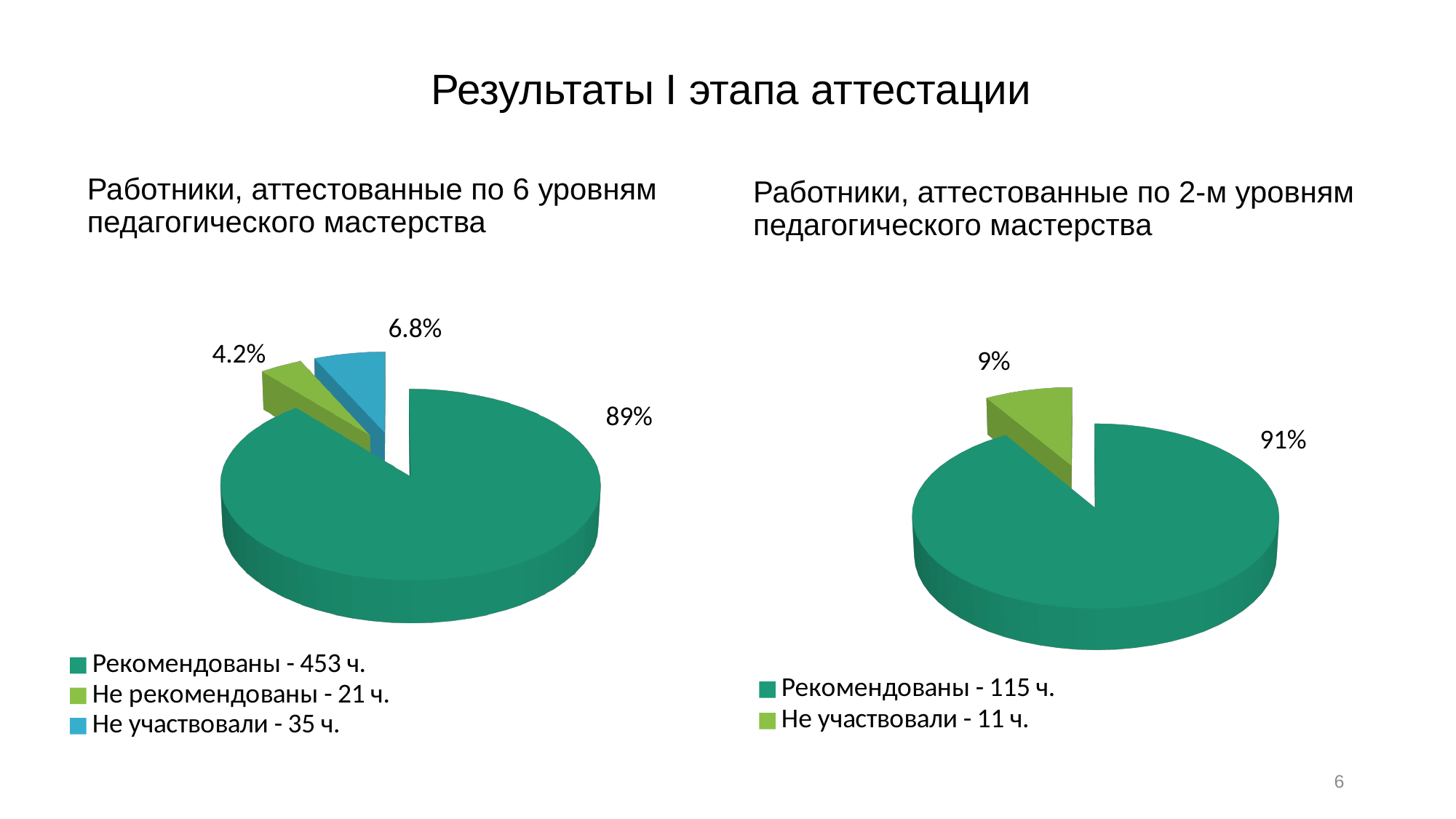
In the left chart (6 уровням), what is the difference in percentage points between "Не участвовали" and "Не рекомендованы"? 2.6 In the left chart (6 уровням), what percentage is shown for "Не участвовали"? 6.8% In the left chart (6 уровням), which category has the smallest slice? Не рекомендованы In the left chart (6 уровням), how many slices does the pie have? 3 In the left chart (6 уровням), how many people does the legend give for "Рекомендованы"? 453 ч. What kind of chart is the left chart, "Работники, аттестованные по 6 уровням педагогического мастерства"? pie chart In the left chart (6 уровням), what share of the pie is labelled for "Рекомендованы"? 89% In the right chart (2-м уровням), what share of the pie is labelled for "Рекомендованы"? 91% In the left chart (6 уровням), what percentage is shown for "Не рекомендованы"? 4.2% Which is larger: the "Рекомендованы" share in the left chart or the "Рекомендованы" share in the right chart? the right chart (91%) In the right chart (2-м уровням), how many entries does the legend list? 2 In the right chart (2-м уровням), what percentage is shown for "Не участвовали"? 9%